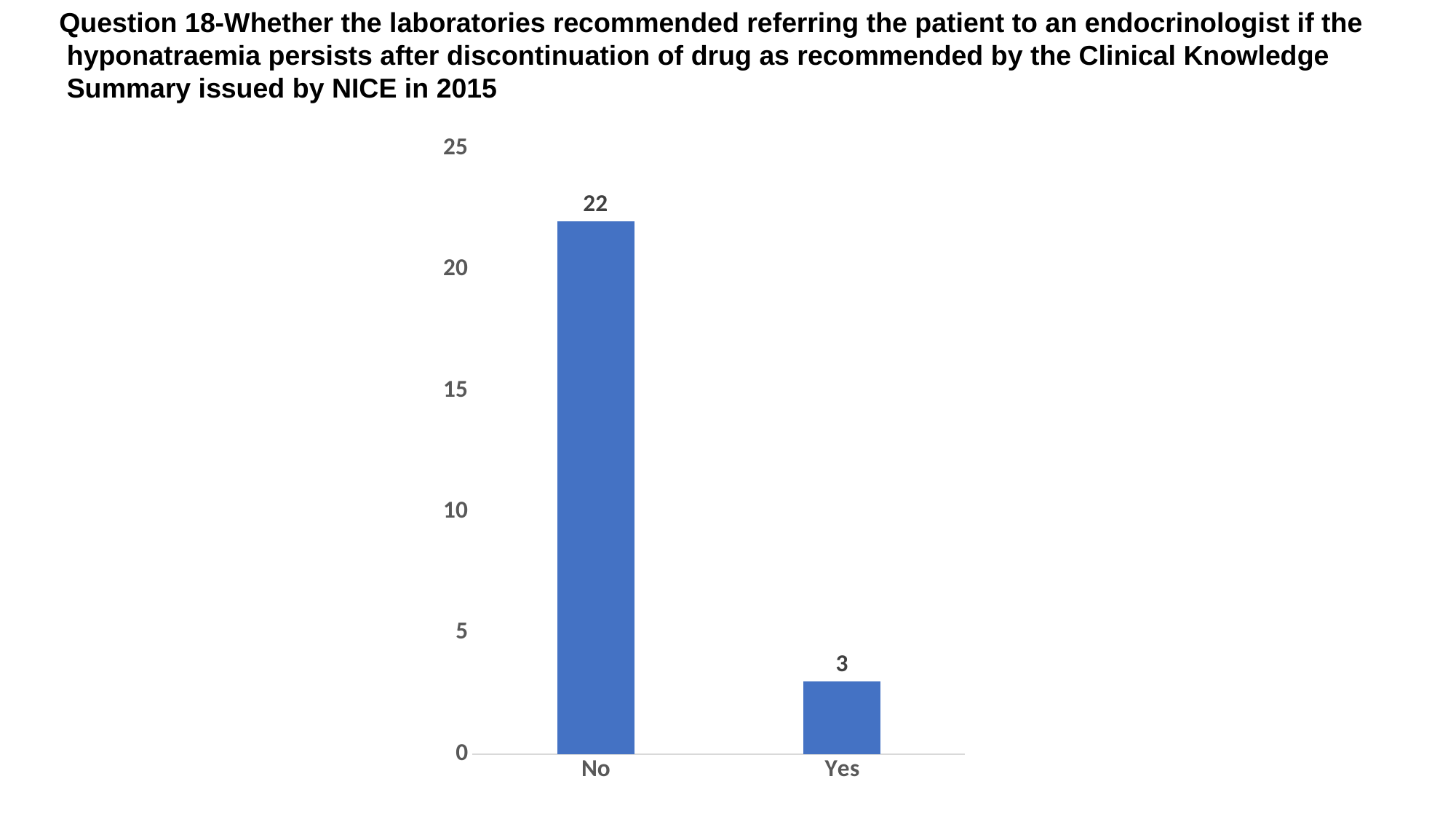
What is the highest value shown on the y axis? 25 What is the value for the 'No' category? 22 Which category has the lowest value? Yes What is the value for the 'Yes' category? 3 What kind of chart is shown on the slide? bar chart Is the value for 'Yes' greater or less than 5? less What is the difference between the values for 'No' and 'Yes'? 19 What is the total of the two bars combined? 25 Which is larger, the value for 'No' or the value for 'Yes'? No How many categories are shown on the x axis? 2 Is the value for 'No' greater or less than 20? greater Which category has the highest value? No